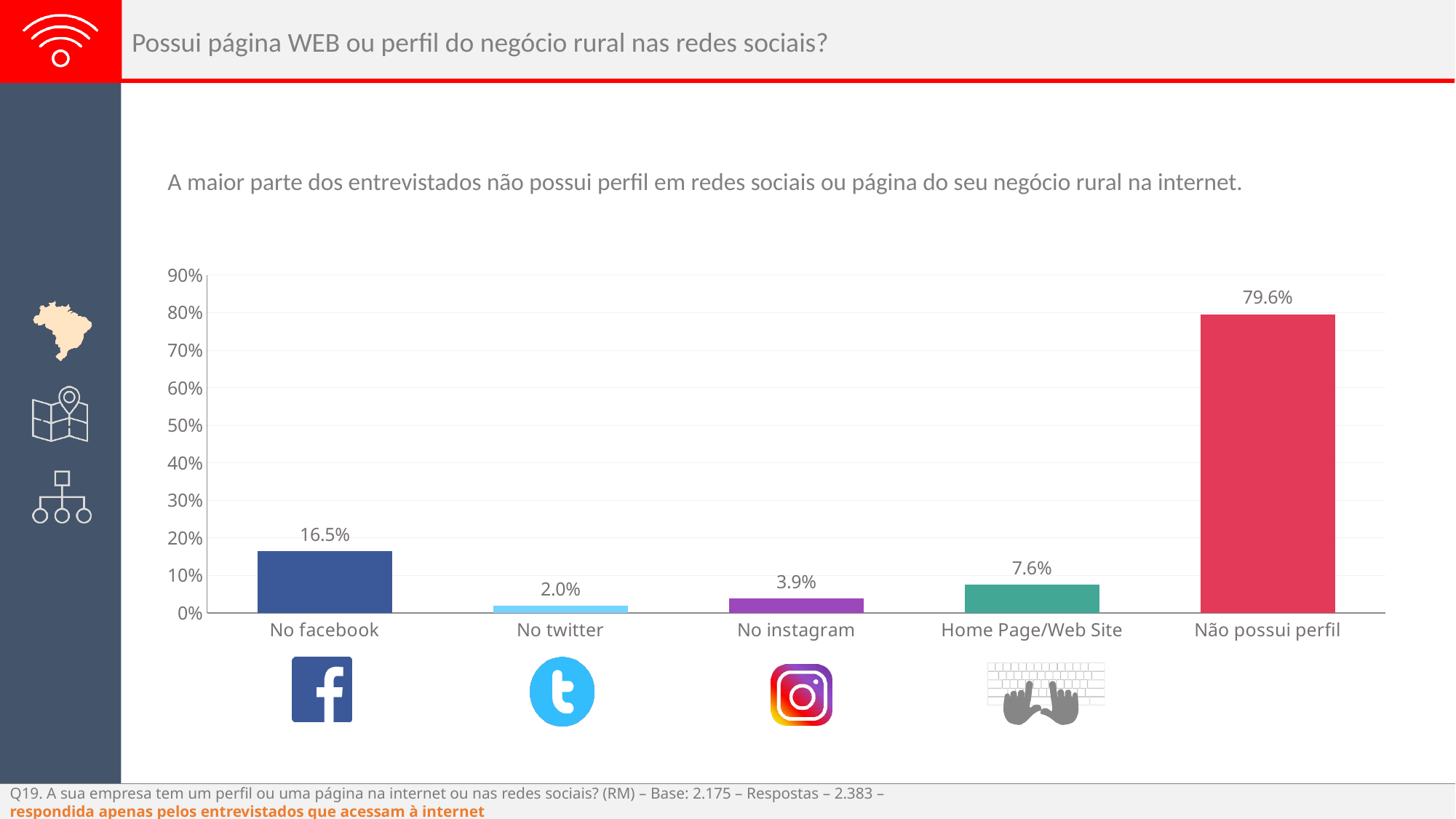
What is the highest value shown on the vertical axis? 90% Which category has the highest value? Não possui perfil What is the difference between "Não possui perfil" and "No facebook"? 63.1% Is the value for "No facebook" greater or less than 20%? less What kind of chart is shown on the slide? bar chart How many categories are shown on the x axis? 5 Which is larger, "No instagram" or "Home Page/Web Site"? Home Page/Web Site What is the value for "No facebook"? 16.5% Which category has the lowest value? No twitter What is the value for "Não possui perfil"? 79.6% What is the value for "No instagram"? 3.9% What is the value for "Home Page/Web Site"? 7.6%